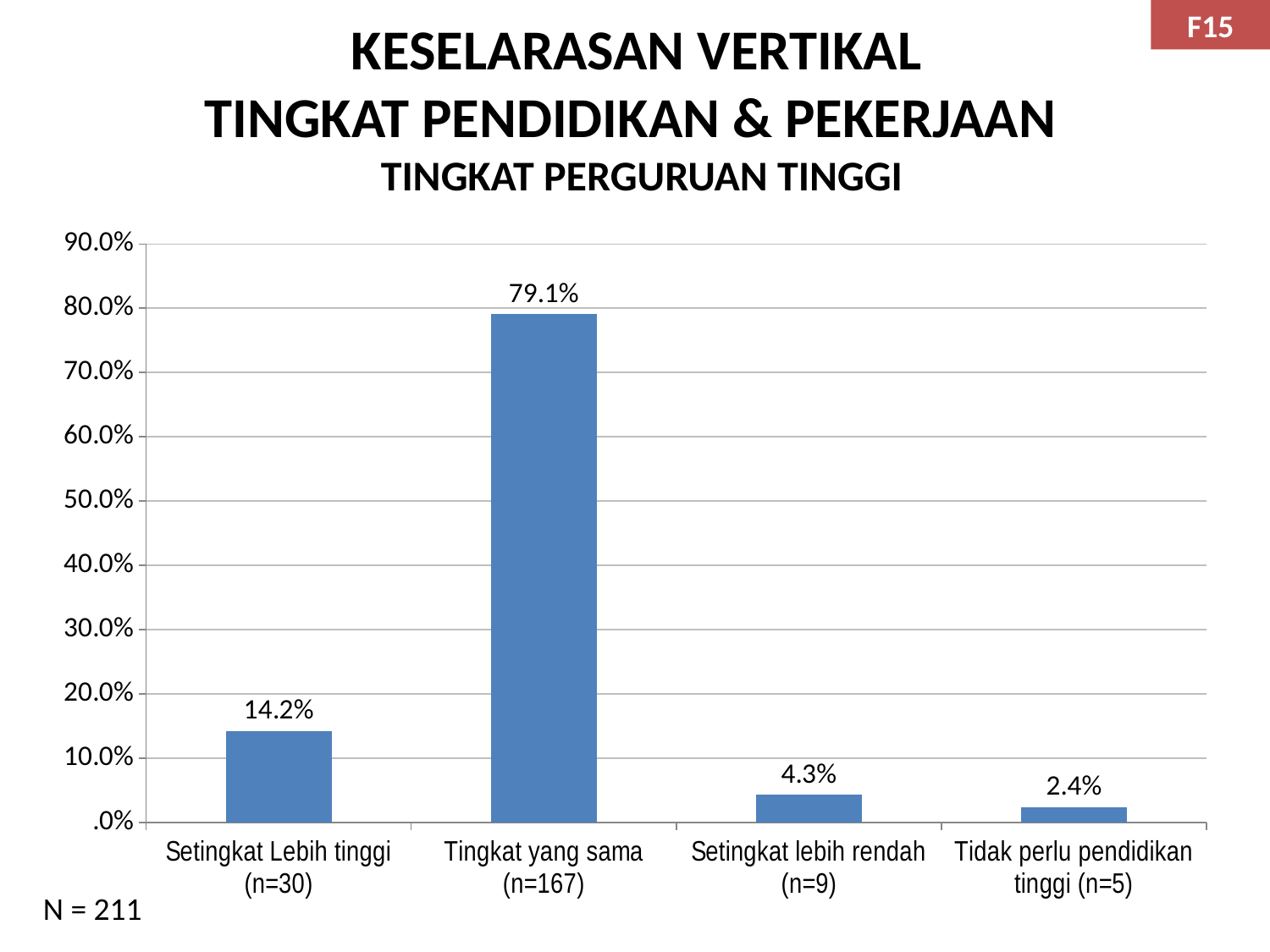
What kind of chart is shown on the slide? bar chart What is the value for "Setingkat lebih rendah (n=9)"? 4.3% What is the value for "Tingkat yang sama (n=167)"? 79.1% What is the value for "Tidak perlu pendidikan tinggi (n=5)"? 2.4% Which is larger, the value for "Setingkat lebih rendah (n=9)" or "Tidak perlu pendidikan tinggi (n=5)"? Setingkat lebih rendah (n=9) Which category has the lowest value? Tidak perlu pendidikan tinggi (n=5) What is the difference between the values for "Tingkat yang sama (n=167)" and "Setingkat Lebih tinggi (n=30)"? 64.9% Is the value for "Setingkat Lebih tinggi (n=30)" greater or less than 20.0%? less What is the total N stated below the chart? N = 211 What is the value for "Setingkat Lebih tinggi (n=30)"? 14.2% Which category has the highest value? Tingkat yang sama (n=167) How many categories are shown on the x axis? 4